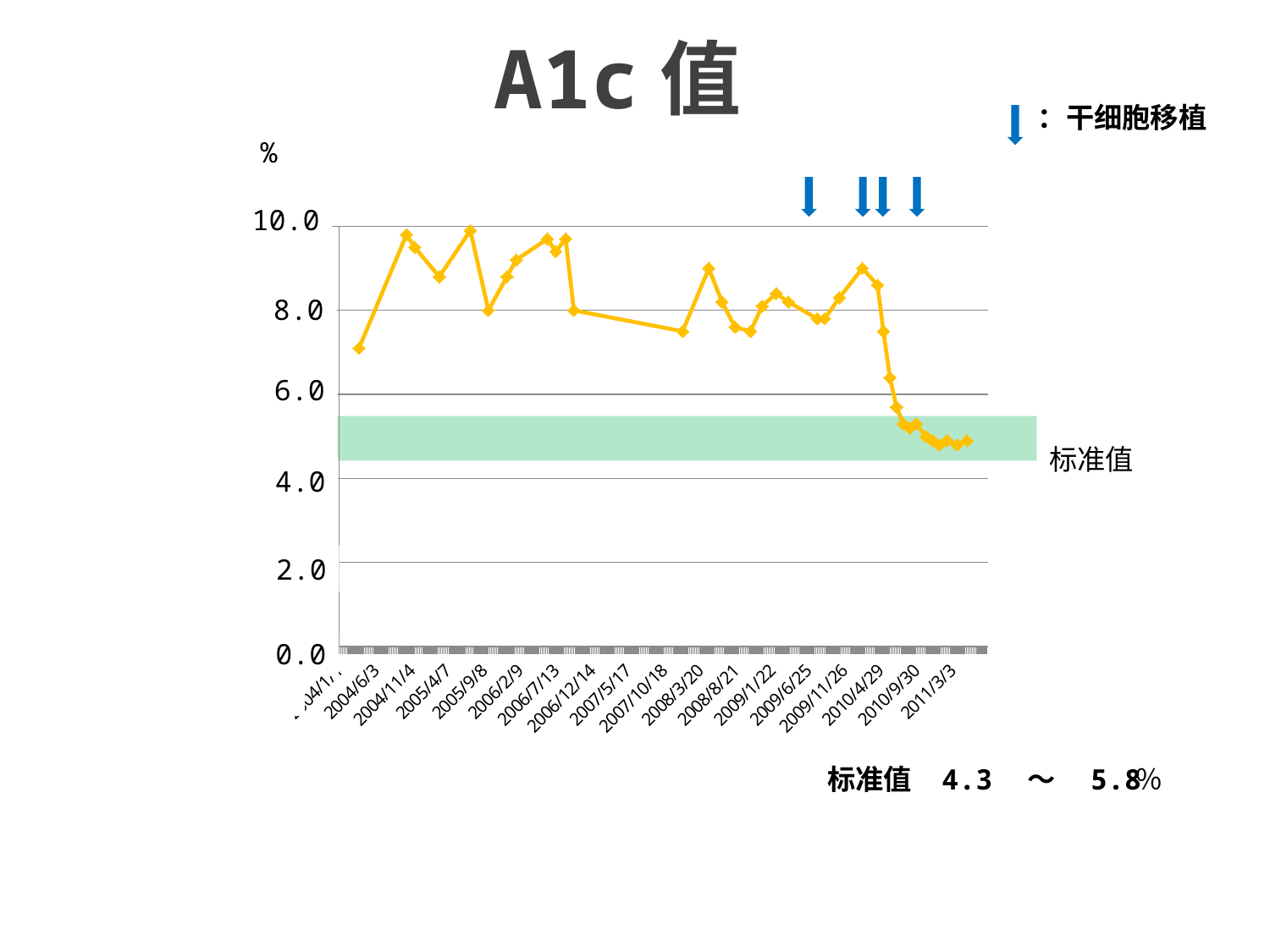
What kind of chart is shown on the slide? line chart Is the value around 2004/11/14 greater or less than 8.0? greater Is the value at the last point greater or less than 4.0? greater Is the value at the first point of the series (2004) greater or less than 6.0? greater According to the legend, what do the blue arrows above the chart indicate? 干细胞移植 Overall, do the A1c values rise or fall from the start of the series to the end? fall What is the title of the chart? A1c 値